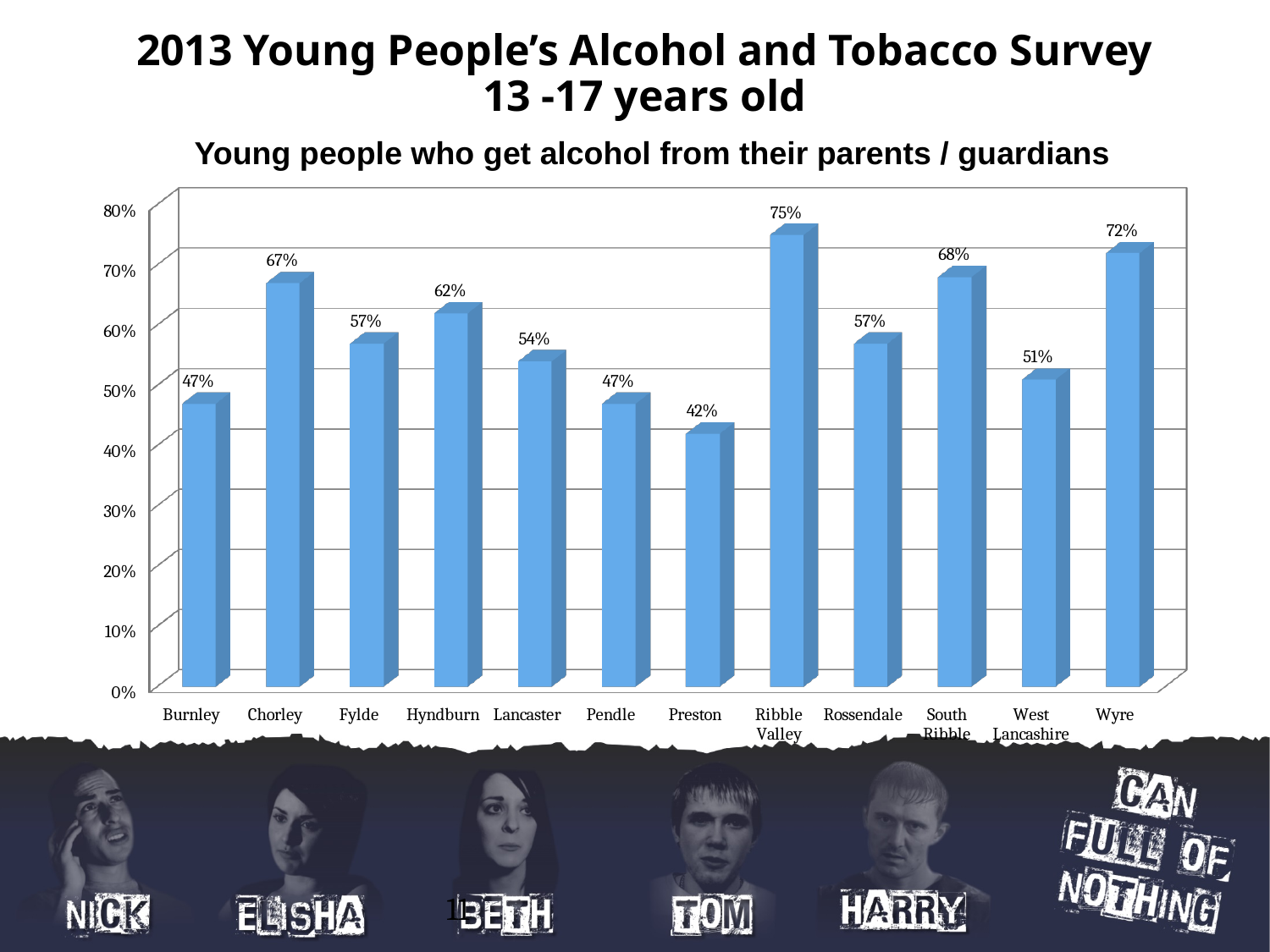
What percentage of young people in Chorley get alcohol from their parents / guardians? 67% What kind of chart is shown on the slide? bar chart What is the title of the chart? Young people who get alcohol from their parents / guardians What is the difference between the values for Wyre and Burnley? 25% How many areas are shown on the x axis? 12 What is the value shown for Preston? 42% Which area has the highest percentage of young people getting alcohol from their parents / guardians? Ribble Valley What is the value shown for South Ribble? 68% Is the value for West Lancashire greater or less than 60%? less Which area has the lowest percentage? Preston Which two areas both show a value of 47%? Burnley and Pendle Which is larger, the value for Hyndburn or the value for Lancaster? Hyndburn